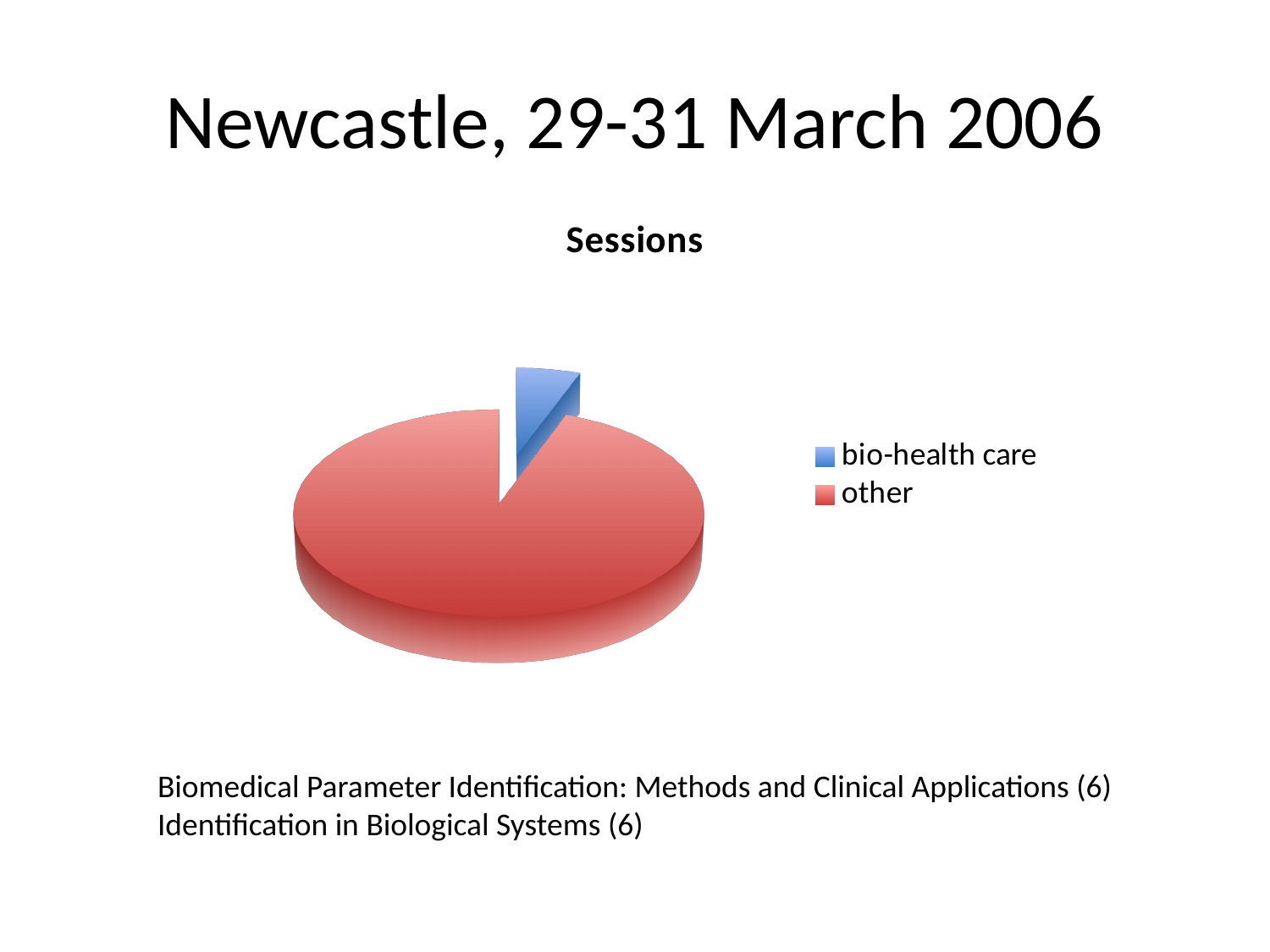
How many slices does the pie chart have? 2 What colour is the bio-health care slice? blue What kind of chart is shown on the slide? pie chart How many entries does the legend list? 2 Which slice of the pie is the largest? other What is the title of the chart? Sessions Which is larger, the bio-health care slice or the other slice? other Which slice of the pie is the smallest? bio-health care Which slice is pulled out (exploded) from the pie? bio-health care